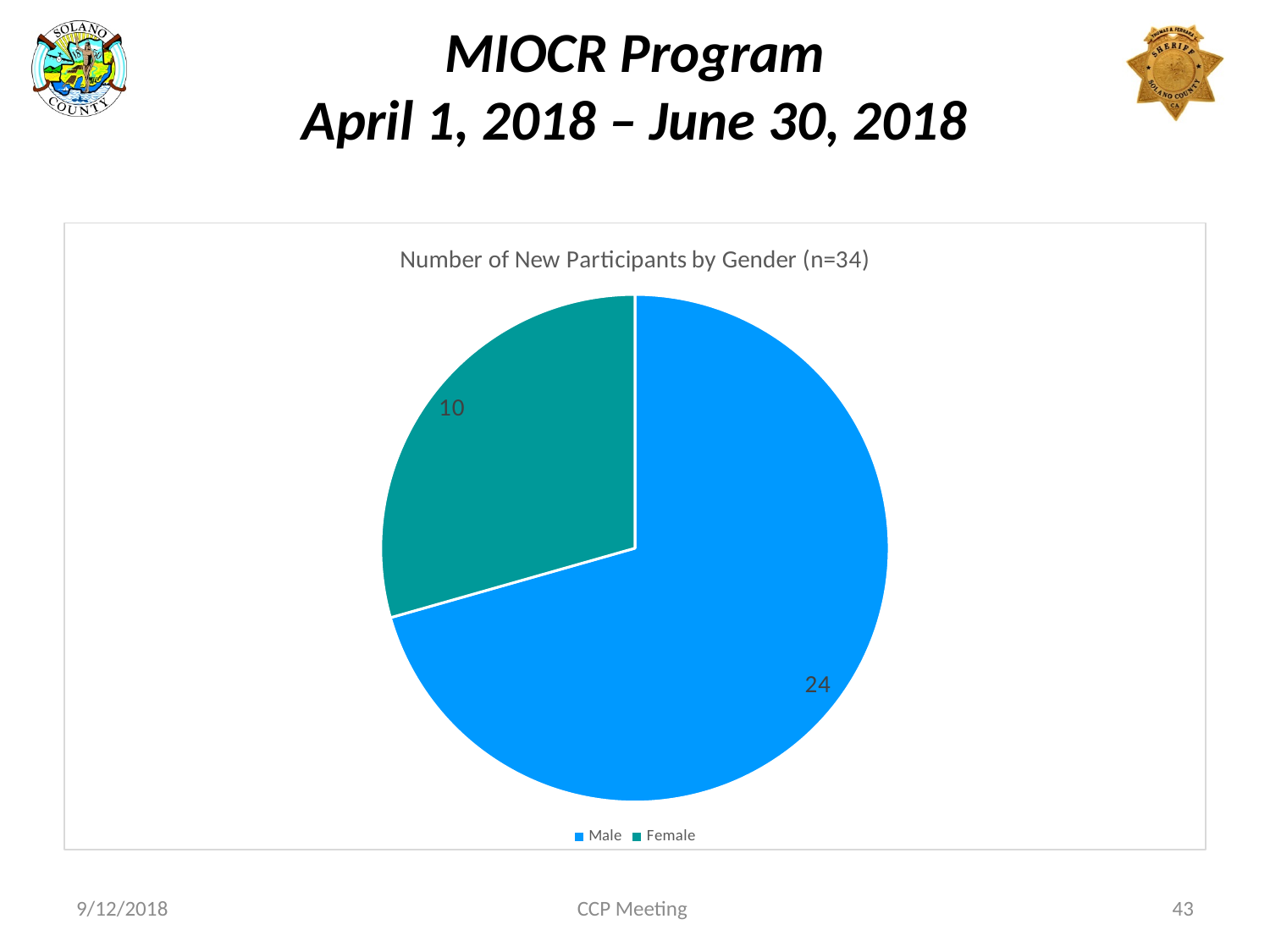
Which gender has the smaller slice of the pie? Female What is the title of the chart? Number of New Participants by Gender (n=34) Are there more Male or Female new participants? Male Which colour represents Female in the pie chart? teal (green) What type of chart is shown on the slide? pie chart Which gender has the larger slice of the pie? Male How many new participants were Male? 24 What is the difference between the number of Male and Female new participants? 14 What is the total number of new participants shown in the pie chart? 34 How many entries does the legend list? 2 How many new participants were Female? 10 How many categories does the pie chart show? 2